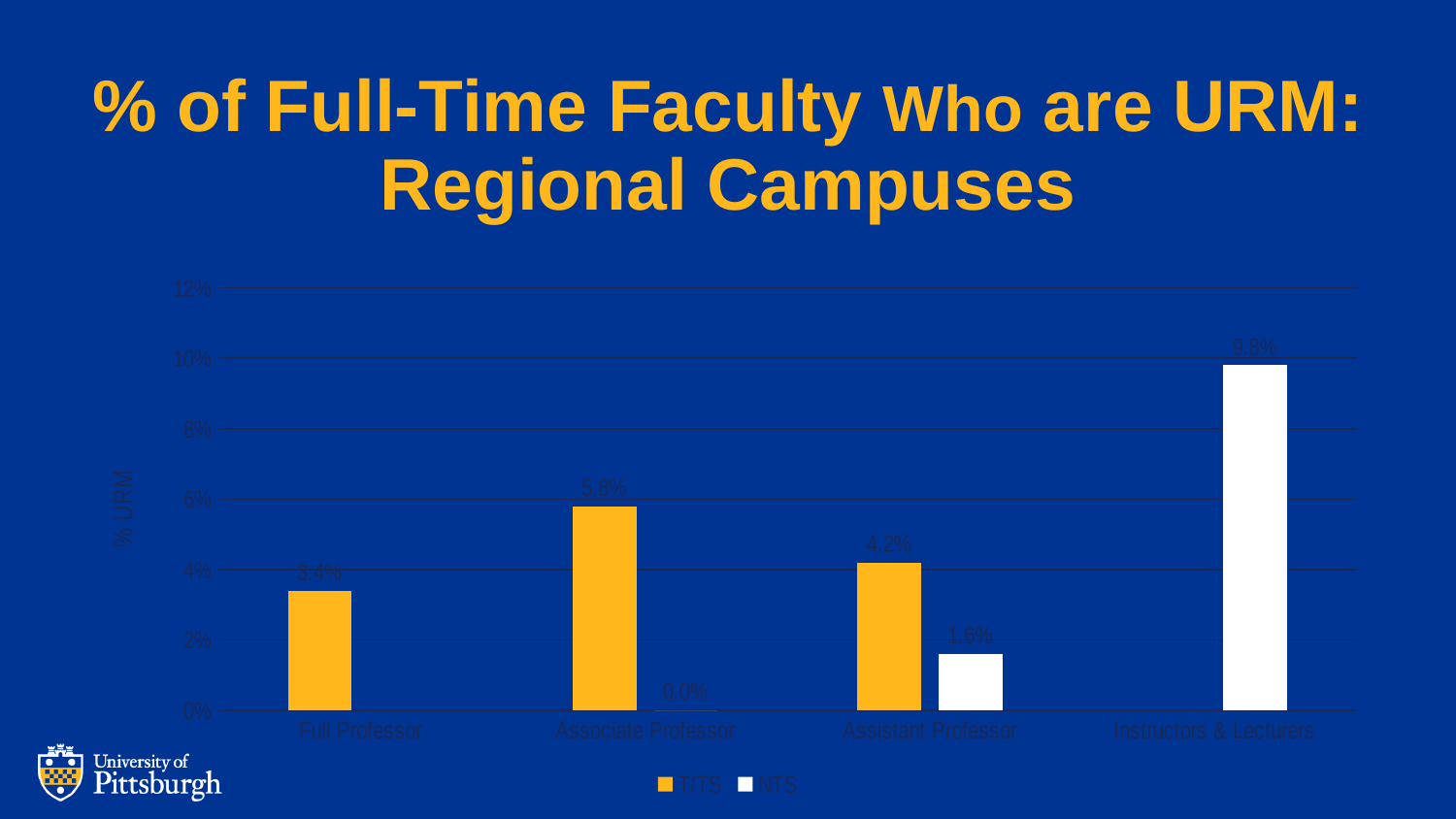
What is the NTS value for Instructors & Lecturers? 9.8% What is the NTS value for Associate Professor? 0.0% What is the T/TS value for Associate Professor? 5.8% How many series does the legend list? 2 How many categories are shown on the x axis? 4 What is the T/TS value for Full Professor? 3.4% Which category has the highest T/TS value? Associate Professor What is the label of the y axis? % URM What kind of chart is shown on the slide? bar chart What is the difference between the T/TS and NTS values for Assistant Professor? 2.6% Which is larger, the T/TS value for Full Professor or the T/TS value for Assistant Professor? Assistant Professor What is the NTS value for Assistant Professor? 1.6%